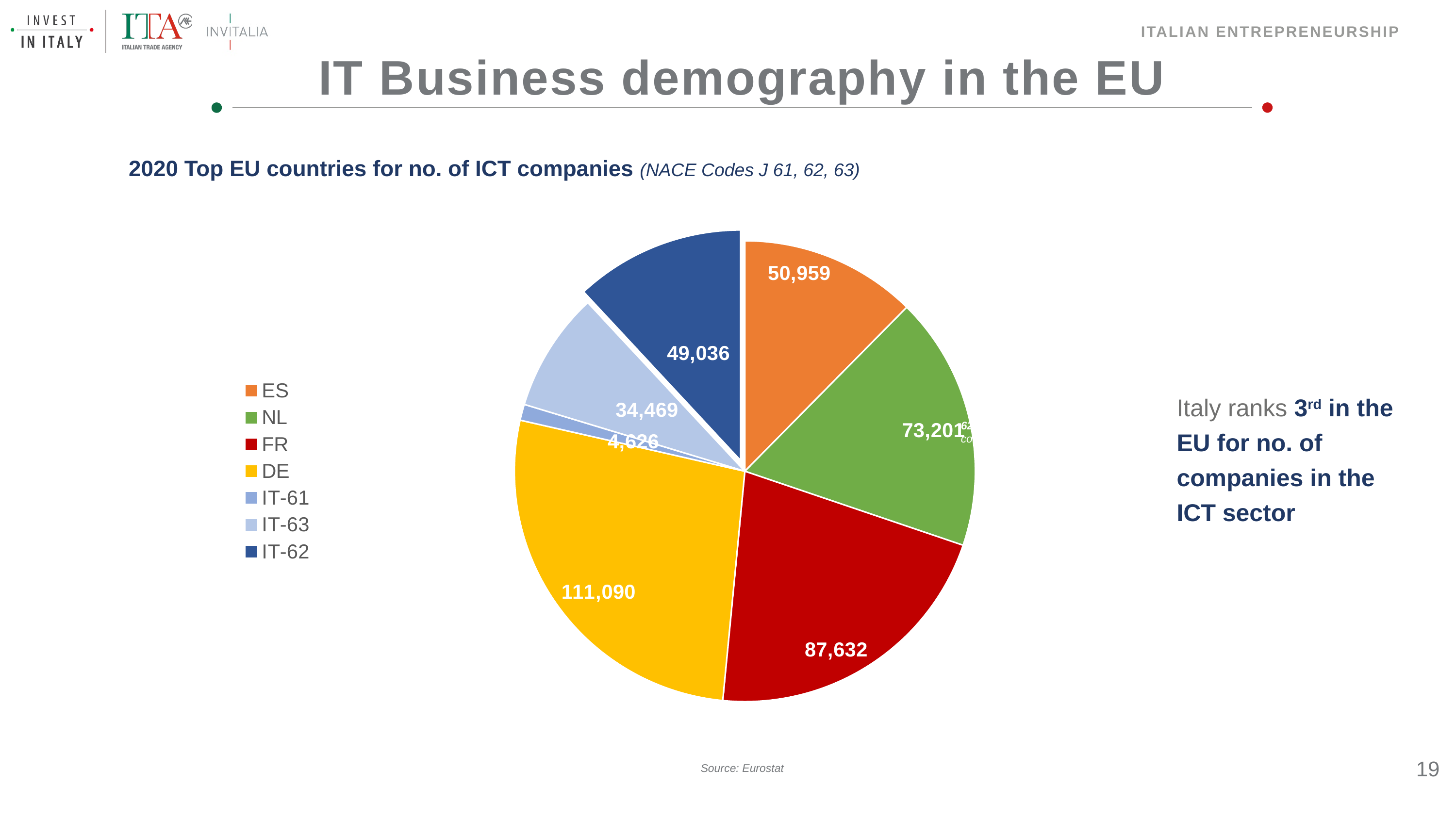
What is the value for DE in the pie chart? 111,090 Which category has the smallest slice in the pie chart? IT-61 What is the value for IT-63 in the pie chart? 34,469 Which category has the largest slice in the pie chart? DE What is the value for IT-61 in the pie chart? 4,626 What is the title of the chart? 2020 Top EU countries for no. of ICT companies How many slices does the pie chart have? 7 What type of chart is shown on the slide? pie chart Which is larger, the value for ES or the value for IT-62? ES What is the difference between the values for DE and FR? 23,458 How many entries does the legend list? 7 What is the value for FR in the pie chart? 87,632